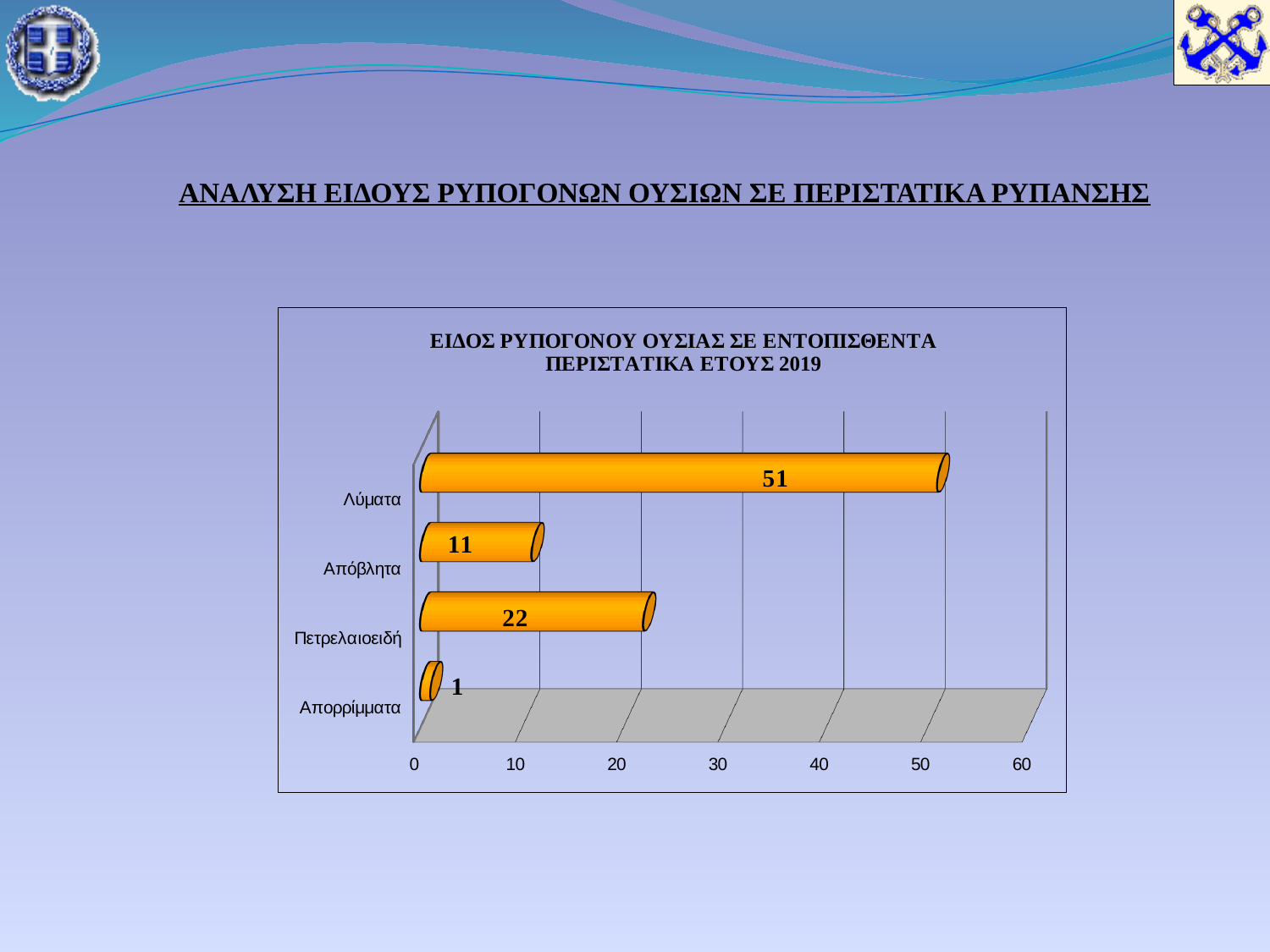
What is the difference between the values for Λύματα and Πετρελαιοειδή? 29 Which category has the highest value? Λύματα Which category has the lowest value? Απορρίμματα What is the value for Απόβλητα? 11 What is the difference between the values for Πετρελαιοειδή and Απόβλητα? 11 What is the value for Λύματα? 51 What kind of chart is shown on the slide? Bar chart What is the title of the chart? ΕΙΔΟΣ ΡΥΠΟΓΟΝΟΥ ΟΥΣΙΑΣ ΣΕ ΕΝΤΟΠΙΣΘΕΝΤΑ ΠΕΡΙΣΤΑΤΙΚΑ ΕΤΟΥΣ 2019 What is the value for Πετρελαιοειδή? 22 Which is larger, the value for Απόβλητα or the value for Πετρελαιοειδή? Πετρελαιοειδή What is the value for Απορρίμματα? 1 How many categories are shown in the chart? 4